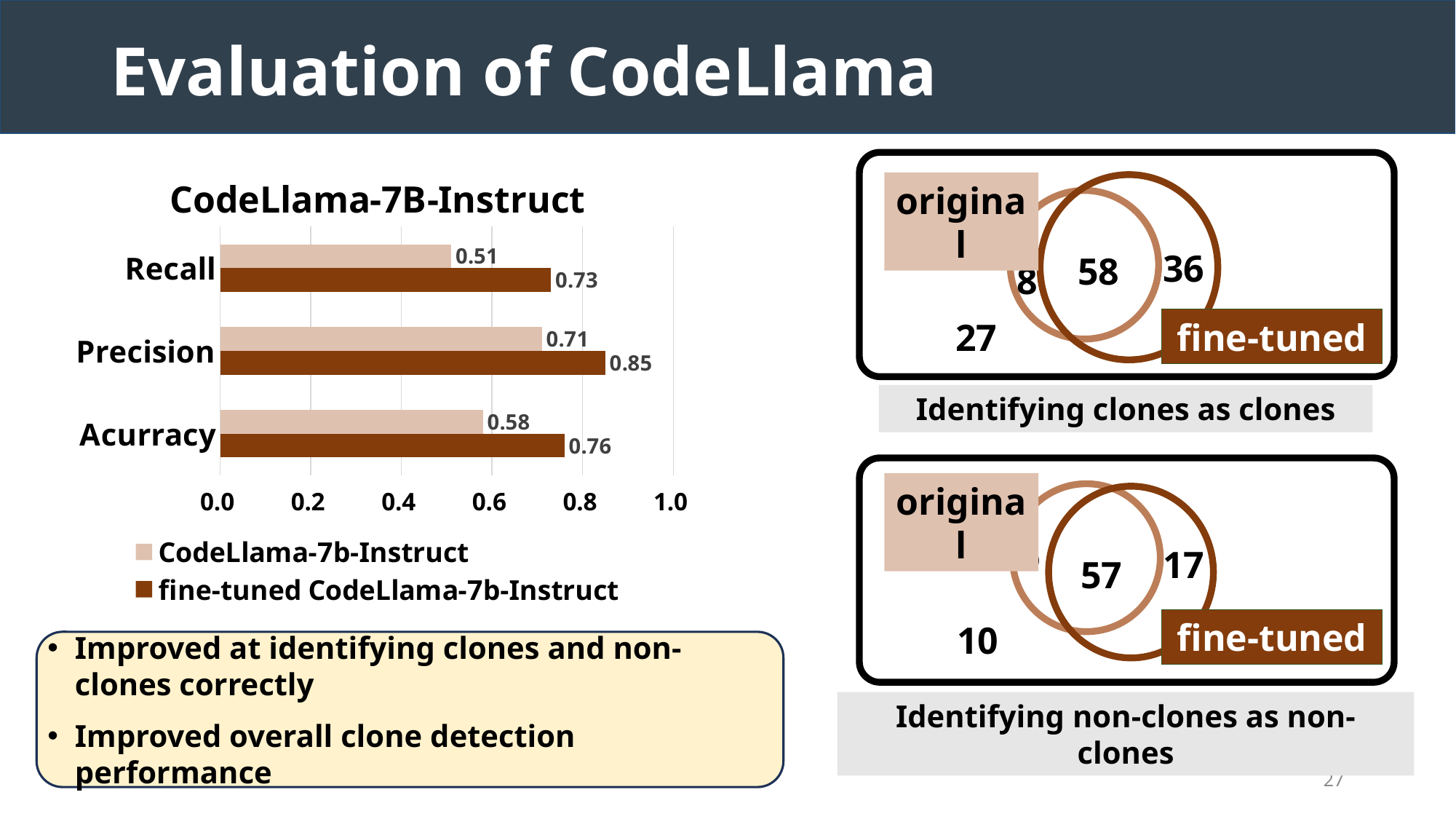
In the CodeLlama-7B-Instruct chart, what is the difference between the fine-tuned and original Recall values? 0.22 In the CodeLlama-7B-Instruct chart, which metric has the highest value for fine-tuned CodeLlama-7b-Instruct? Precision What type of chart is the CodeLlama-7B-Instruct chart? bar chart In the CodeLlama-7B-Instruct chart, what is the Acurracy value for fine-tuned CodeLlama-7b-Instruct? 0.76 In the CodeLlama-7B-Instruct chart, is the Recall value for CodeLlama-7b-Instruct greater or less than 0.6? less In the CodeLlama-7B-Instruct chart, which is larger: the Acurracy of CodeLlama-7b-Instruct or the Acurracy of fine-tuned CodeLlama-7b-Instruct? fine-tuned CodeLlama-7b-Instruct In the CodeLlama-7B-Instruct chart, what is the difference between the fine-tuned and original Precision values? 0.14 In the CodeLlama-7B-Instruct chart, what is the Recall value for fine-tuned CodeLlama-7b-Instruct? 0.73 In the CodeLlama-7B-Instruct chart, which metric has the lowest value for CodeLlama-7b-Instruct? Recall In the CodeLlama-7B-Instruct chart, what is the Precision value for CodeLlama-7b-Instruct? 0.71 How many metrics (categories) are shown in the CodeLlama-7B-Instruct chart? 3 How many series does the legend of the CodeLlama-7B-Instruct chart list? 2